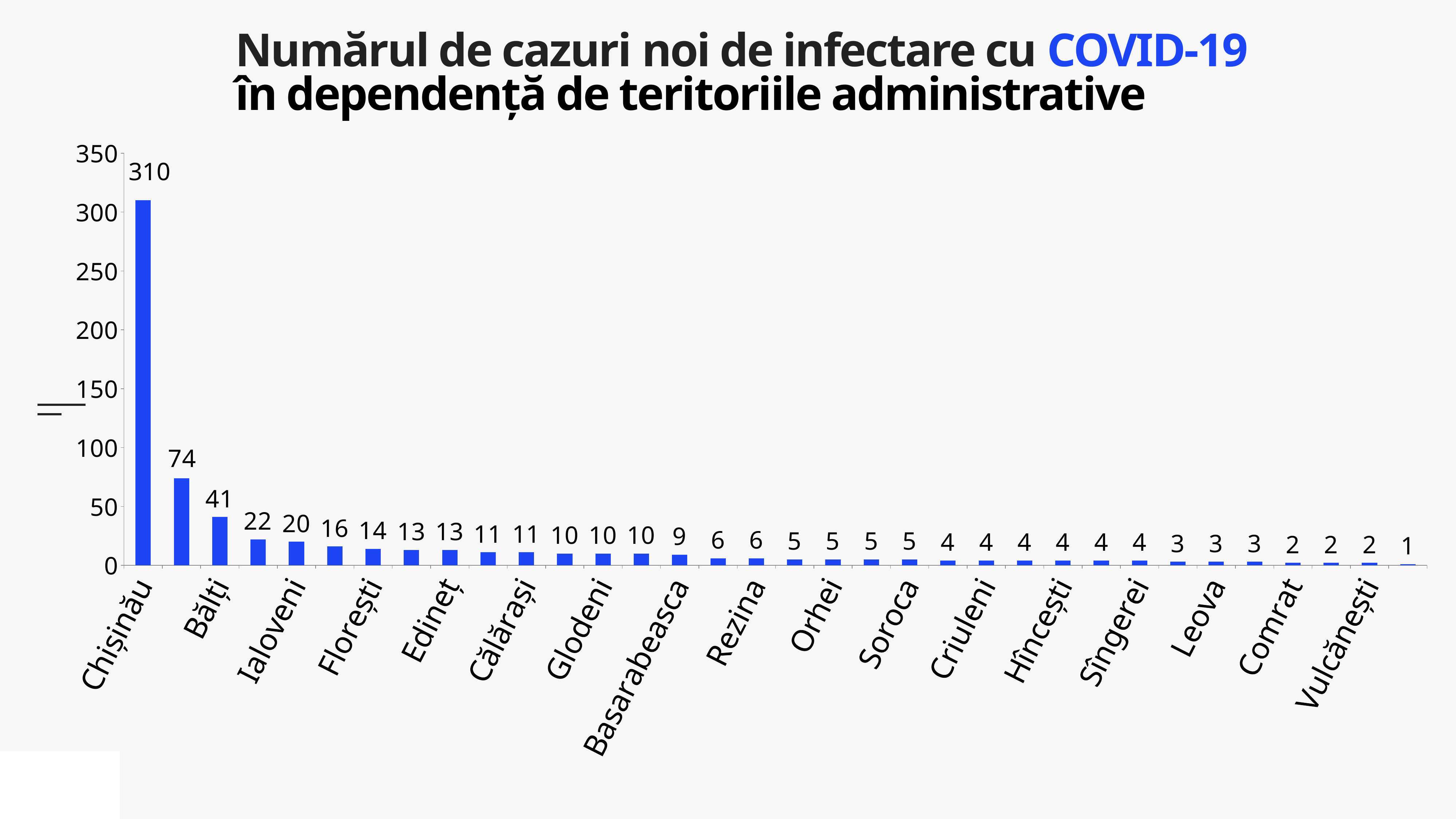
What is the highest value shown on the vertical axis? 350 What colour are the bars in the chart? blue What is the value of the tallest bar? 310 What is the value of the shortest bar? 1 Which category has the highest value? Chișinău Is the value for Chișinău greater or less than 300? greater What is the value for Chișinău? 310 Do the values rise or fall from left to right along the x axis? fall What is the difference between the tallest bar (310) and the second tallest bar (74)? 236 How many bars are plotted in the chart? 34 What is the value of the second tallest bar? 74 What kind of chart is shown on the slide? bar chart